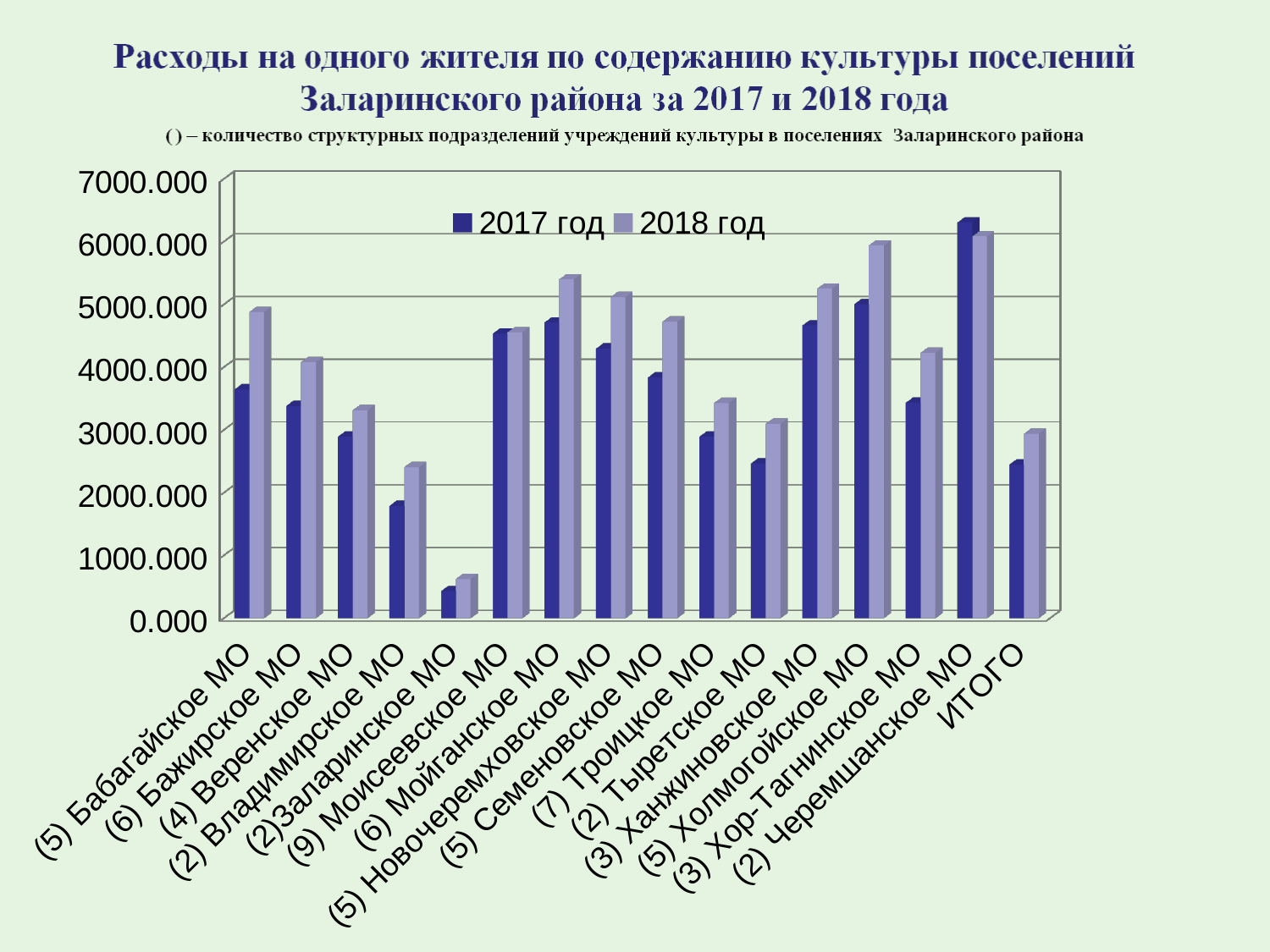
Is the 2018 год value for (5) Холмогойское МО greater or less than 5000.000? greater What kind of chart is shown on the slide? bar chart Which is larger: the 2017 год value for (5) Холмогойское МО or the 2017 год value for (2) Тыретское МО? (5) Холмогойское МО Which category has the highest value for 2017 год? (2) Черемшанское МО How many series does the legend list? 2 For (5) Бабагайское МО, which is larger: the 2017 год value or the 2018 год value? 2018 год How many categories are shown along the x axis? 16 Which category has the lowest value for 2017 год? (2)Заларинское МО Is the 2017 год value for (2) Владимирское МО greater or less than 2000.000? less What are the two series named in the legend? 2017 год and 2018 год Is the 2018 год value for (5) Бабагайское МО greater or less than 4000.000? greater Which category has the lowest value for 2018 год? (2)Заларинское МО